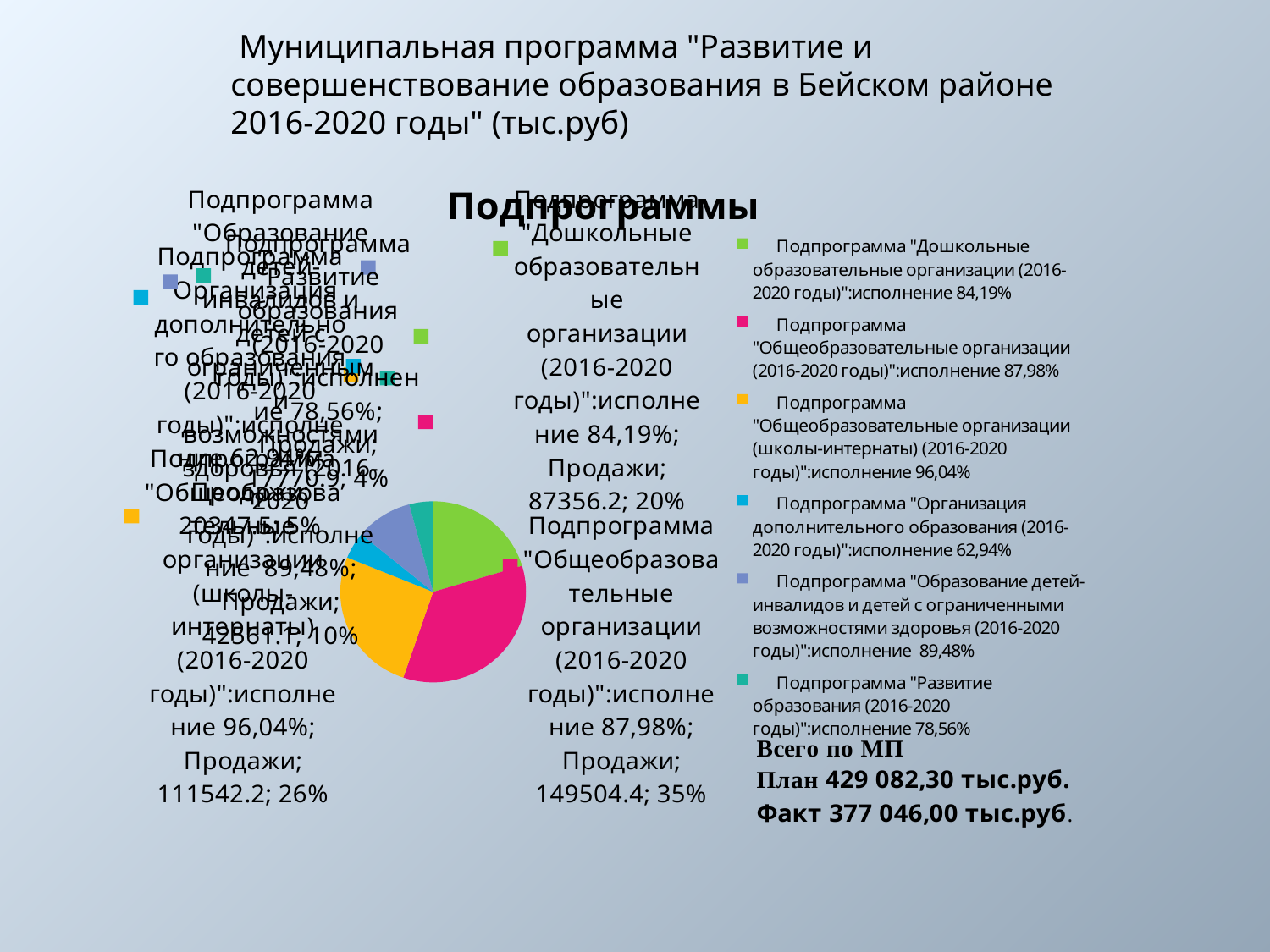
How many slices does the pie chart have? 6 How many entries does the chart legend list? 6 What is the title of the chart? Подпрограммы What kind of chart is shown on the slide? pie chart What colour is the slice for Подпрограмма "Общеобразовательные организации (школы-интернаты)"? yellow Which subprogram has the largest slice of the pie? Подпрограмма "Общеобразовательные организации (2016-2020 годы)" What value is shown for the slice Подпрограмма "Общеобразовательные организации (школы-интернаты) (2016-2020 годы)"? 111542.2 Which is larger: the slice for Подпрограмма "Дошкольные образовательные организации" or the slice for Подпрограмма "Организация дополнительного образования"? Подпрограмма "Дошкольные образовательные организации" What share of the pie does the slice for Подпрограмма "Общеобразовательные организации (2016-2020 годы)" represent? 35% What share of the pie does the slice for Подпрограмма "Общеобразовательные организации (школы-интернаты) (2016-2020 годы)" represent? 26% What value is shown for the slice Подпрограмма "Дошкольные образовательные организации (2016-2020 годы)"? 87356.2 What is the difference between the values for Подпрограмма "Общеобразовательные организации (2016-2020 годы)" (149504.4) and Подпрограмма "Дошкольные образовательные организации (2016-2020 годы)" (87356.2)? 62148.2